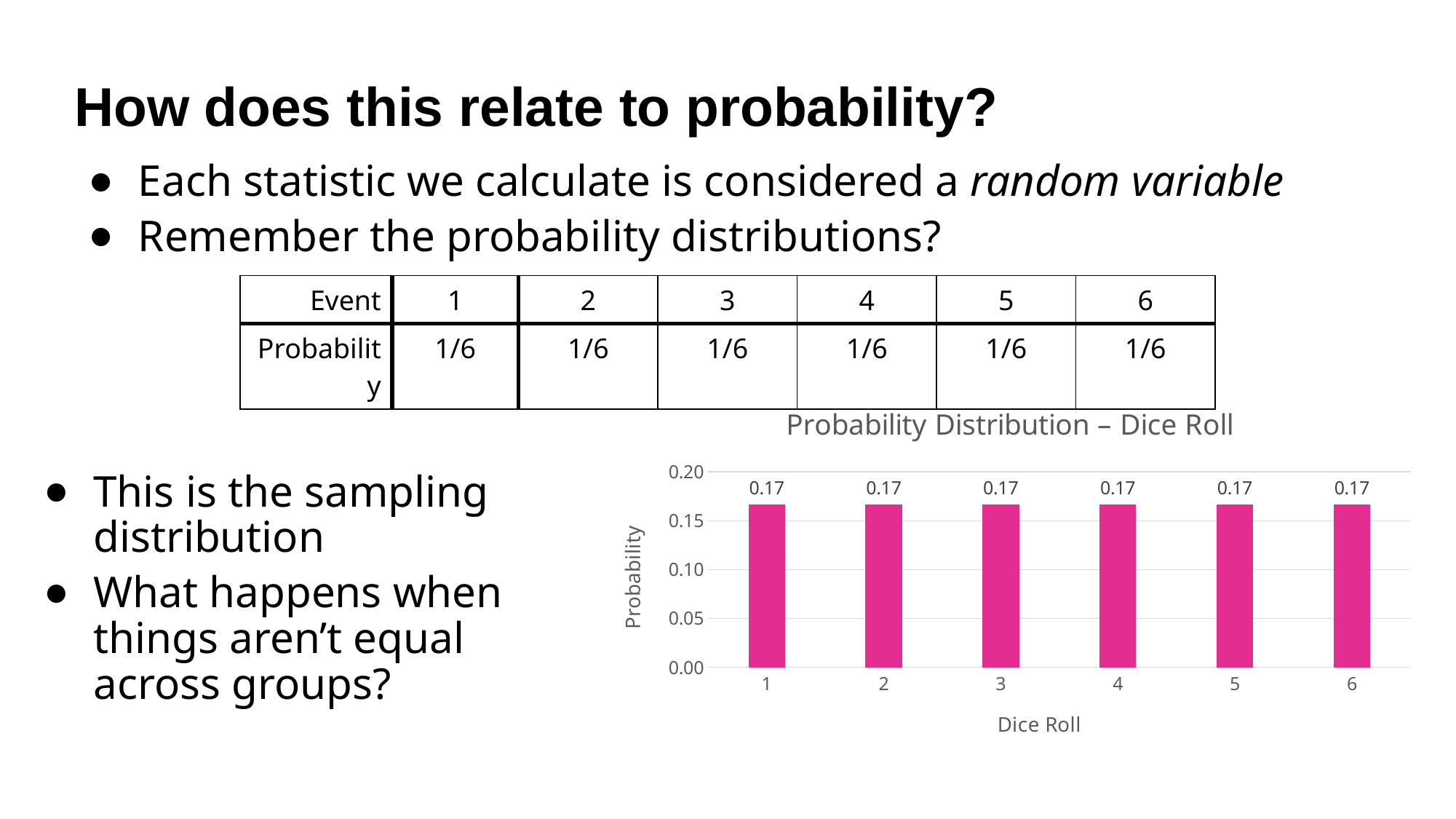
How many dice roll categories are plotted on the x axis? 6 What kind of chart is shown on the slide? bar chart Is the probability for dice roll 2 greater or less than 0.10? greater What is the probability value shown for a dice roll of 6? 0.17 Do the probability values rise, fall, or stay the same across the dice rolls from 1 to 6? stay the same What is the difference between the probability for dice roll 1 and dice roll 5? 0.00 What is the probability value shown for a dice roll of 3? 0.17 Is the probability for dice roll 4 greater or less than 0.20? less What is the title of the chart? Probability Distribution – Dice Roll What is the label of the x axis? Dice Roll What is the highest value shown on the y axis? 0.20